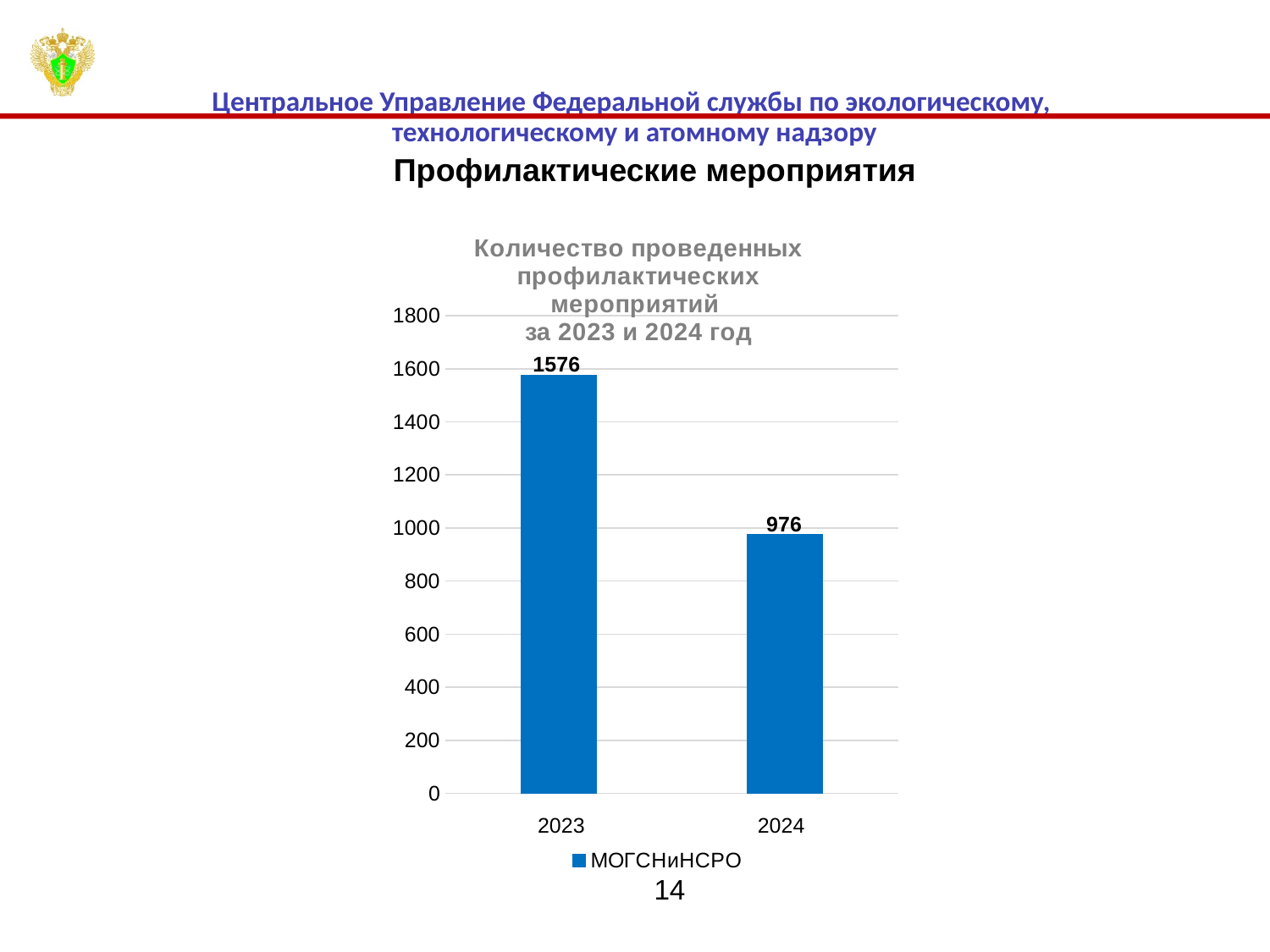
Which is larger, the value for 2023 or the value for 2024? 2023 What is the difference between the values for 2023 and 2024? 600 Do the values rise or fall from 2023 to 2024? fall What is the value for 2023? 1576 Is the value for 2023 greater or less than 1400? greater What is the value for 2024? 976 Which year has the lowest value? 2024 How many series does the legend list? 1 What kind of chart is shown? bar chart Is the value for 2024 greater or less than 1000? less Which year has the highest value? 2023 How many categories are shown on the x axis? 2